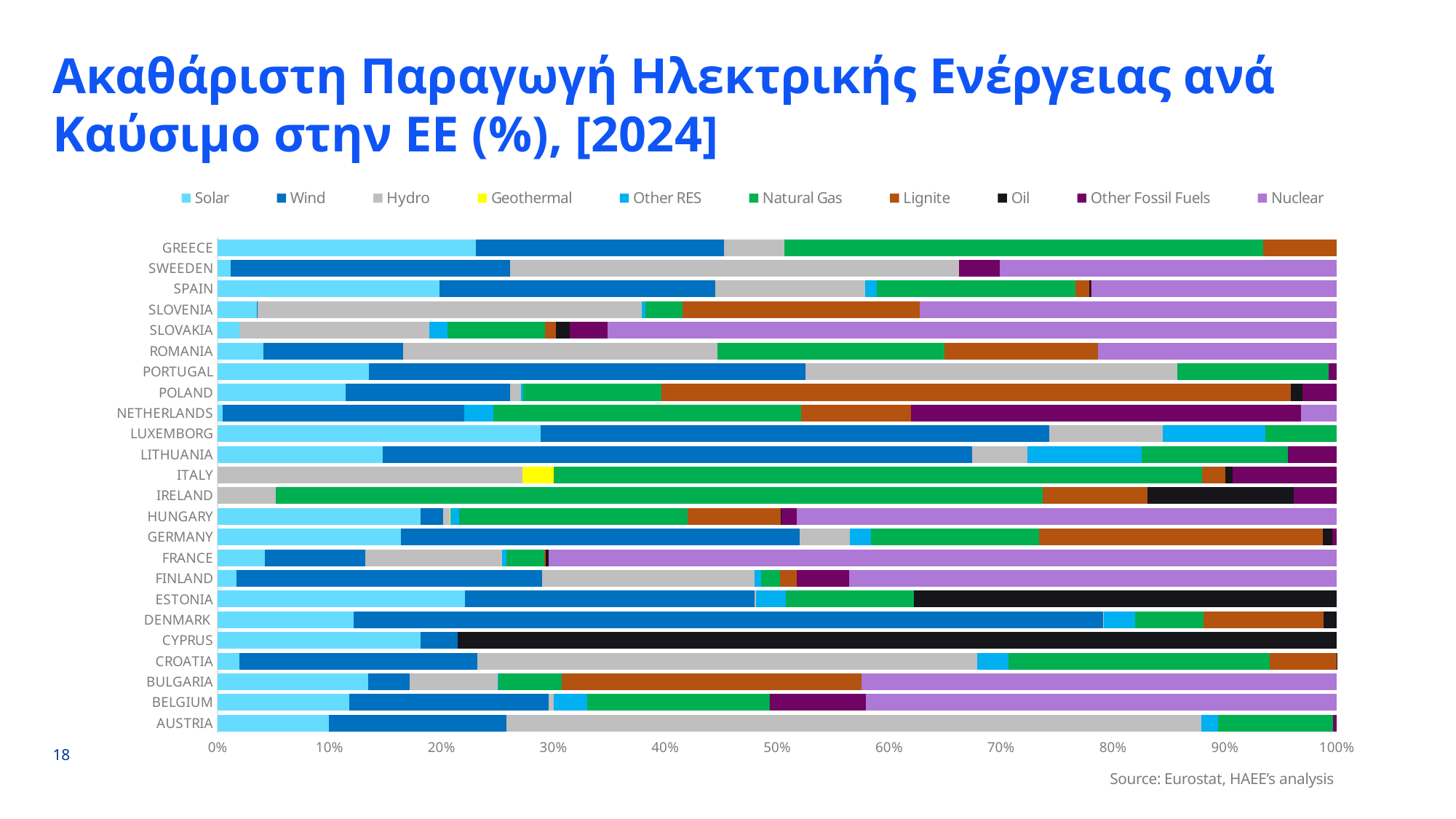
What kind of chart is shown on the slide? Stacked bar chart Which country has the largest Oil share? Cyprus How many series does the legend list? 10 What source is cited below the chart? Eurostat, HAEE's analysis Is the Nuclear share for France greater or less than 60%? greater Is the Oil share for Cyprus greater or less than 70%? greater What is the title of the chart on the slide? Ακαθάριστη Παραγωγή Ηλεκτρικής Ενέργειας ανά Καύσιμο στην ΕΕ (%), [2024] How many countries are listed on the chart? 24 For Cyprus, which is larger: the Oil share or the Solar share? Oil Is the Hydro share for Austria greater or less than 50%? greater